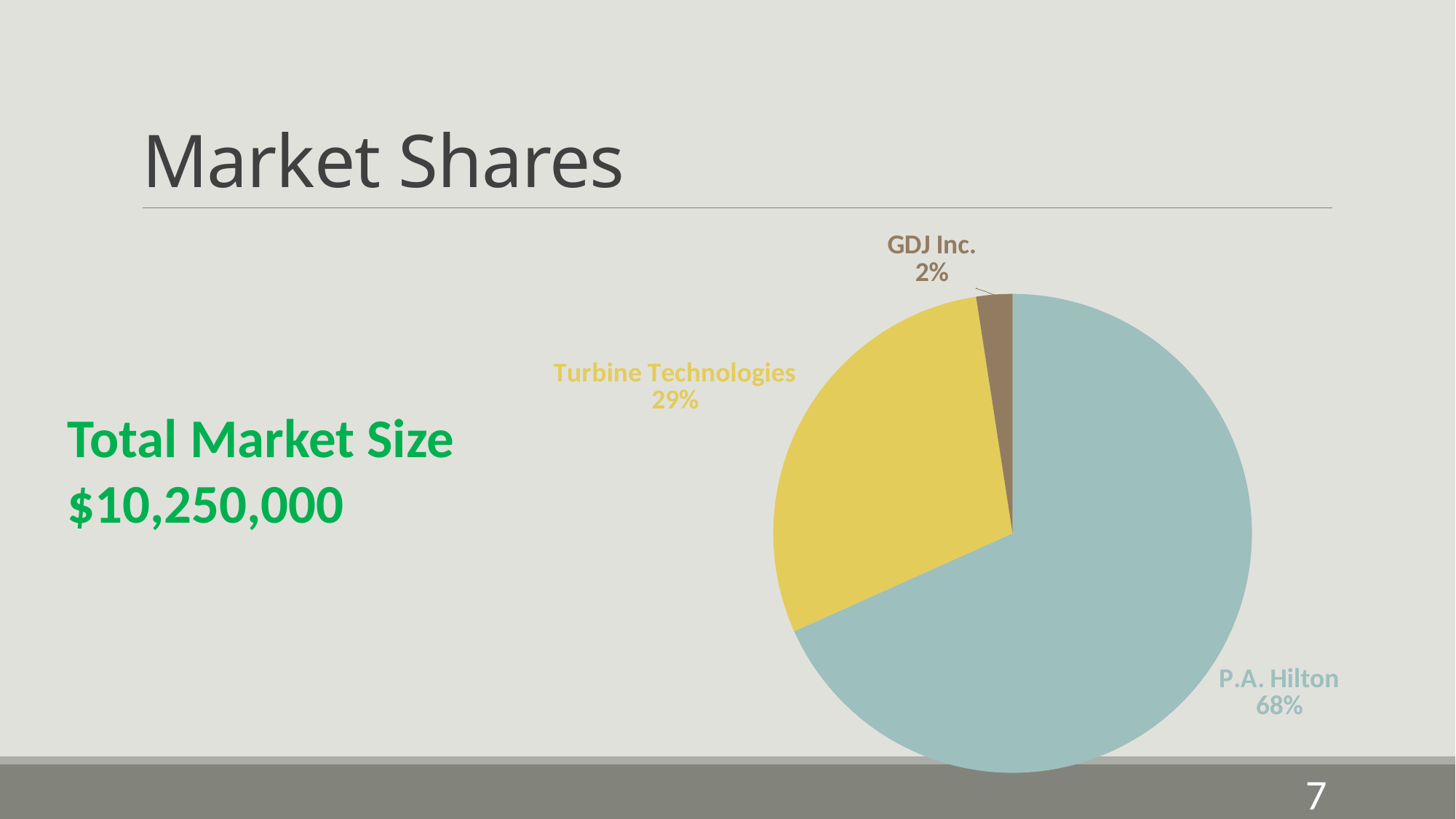
What is the title of the slide containing the pie chart? Market Shares Which has a larger market share, Turbine Technologies or GDJ Inc.? Turbine Technologies How many companies are shown in the pie chart? 3 What share of the market does GDJ Inc. hold? 2% What colour is the P.A. Hilton slice of the pie chart? light blue-grey What kind of chart is shown on the slide? pie chart What is the difference in market share between P.A. Hilton and Turbine Technologies? 39% What share of the market does P.A. Hilton hold? 68% What share of the market does Turbine Technologies hold? 29% What is the difference in market share between Turbine Technologies and GDJ Inc.? 27% Which company has the largest market share? P.A. Hilton Which company has the smallest market share? GDJ Inc.